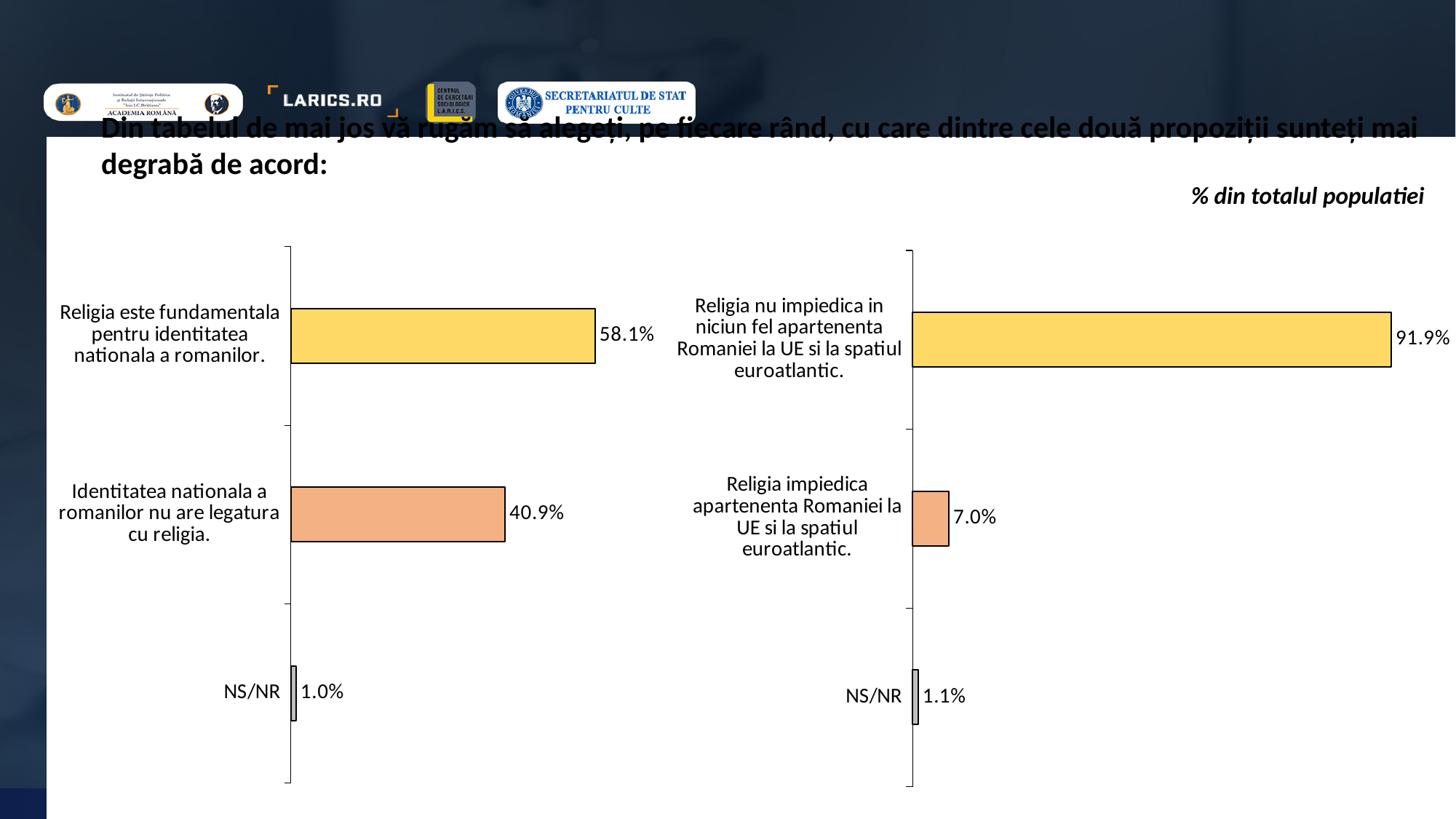
In the right chart, what is the value for NS/NR? 1.1% In the left chart, what is the value for NS/NR? 1.0% What kind of chart is the right chart? Bar chart In the right chart, what is the value for 'Religia impiedica apartenenta Romaniei la UE si la spatiul euroatlantic.'? 7.0% In the right chart, what is the value for 'Religia nu impiedica in niciun fel apartenenta Romaniei la UE si la spatiul euroatlantic.'? 91.9% In the left chart, what is the value for 'Religia este fundamentala pentru identitatea nationala a romanilor.'? 58.1% In the right chart, what is the difference between the values for 'Religia nu impiedica in niciun fel apartenenta Romaniei la UE si la spatiul euroatlantic.' and 'Religia impiedica apartenenta Romaniei la UE si la spatiul euroatlantic.'? 84.9% How many categories does the left chart show? 3 In the left chart, what is the difference between the values for 'Religia este fundamentala pentru identitatea nationala a romanilor.' and 'Identitatea nationala a romanilor nu are legatura cu religia.'? 17.2% In the right chart, which category has the highest value? Religia nu impiedica in niciun fel apartenenta Romaniei la UE si la spatiul euroatlantic. In the left chart, what is the value for 'Identitatea nationala a romanilor nu are legatura cu religia.'? 40.9% In the left chart, which category has the lowest value? NS/NR